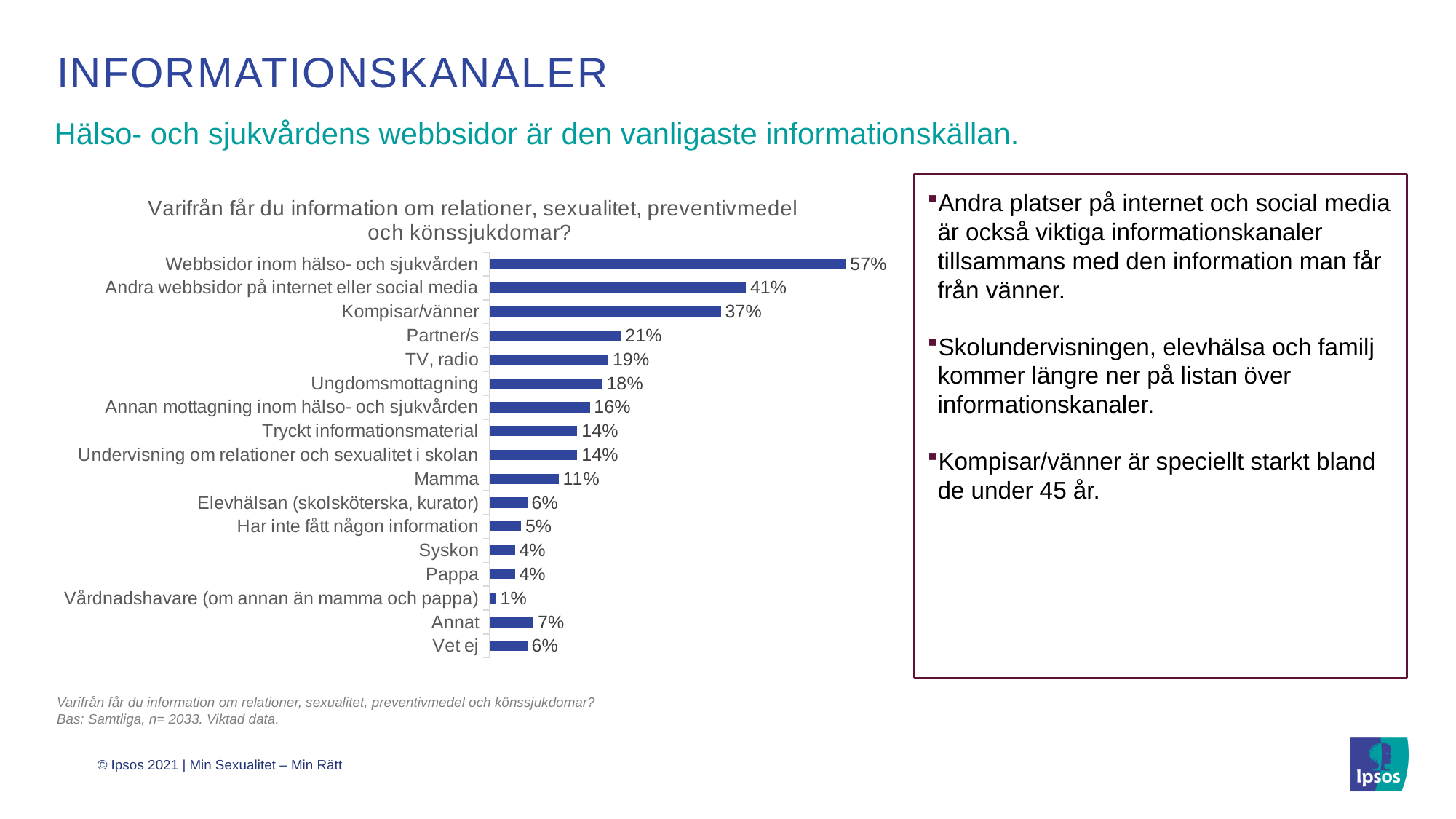
Which is larger, Partner/s or TV, radio? Partner/s How many categories are shown in the chart? 17 What is the value for Ungdomsmottagning? 18% What is the value for Webbsidor inom hälso- och sjukvården? 57% What is the difference between Webbsidor inom hälso- och sjukvården and Andra webbsidor på internet eller social media? 16% What kind of chart is shown on the slide? Bar chart Which category has the lowest value? Vårdnadshavare (om annan än mamma och pappa) What is the value for Mamma? 11% Which category has the highest value? Webbsidor inom hälso- och sjukvården What is the difference between Annat and Har inte fått någon information? 2% What is the value for Kompisar/vänner? 37% What is the title of the chart? Varifrån får du information om relationer, sexualitet, preventivmedel och könssjukdomar?